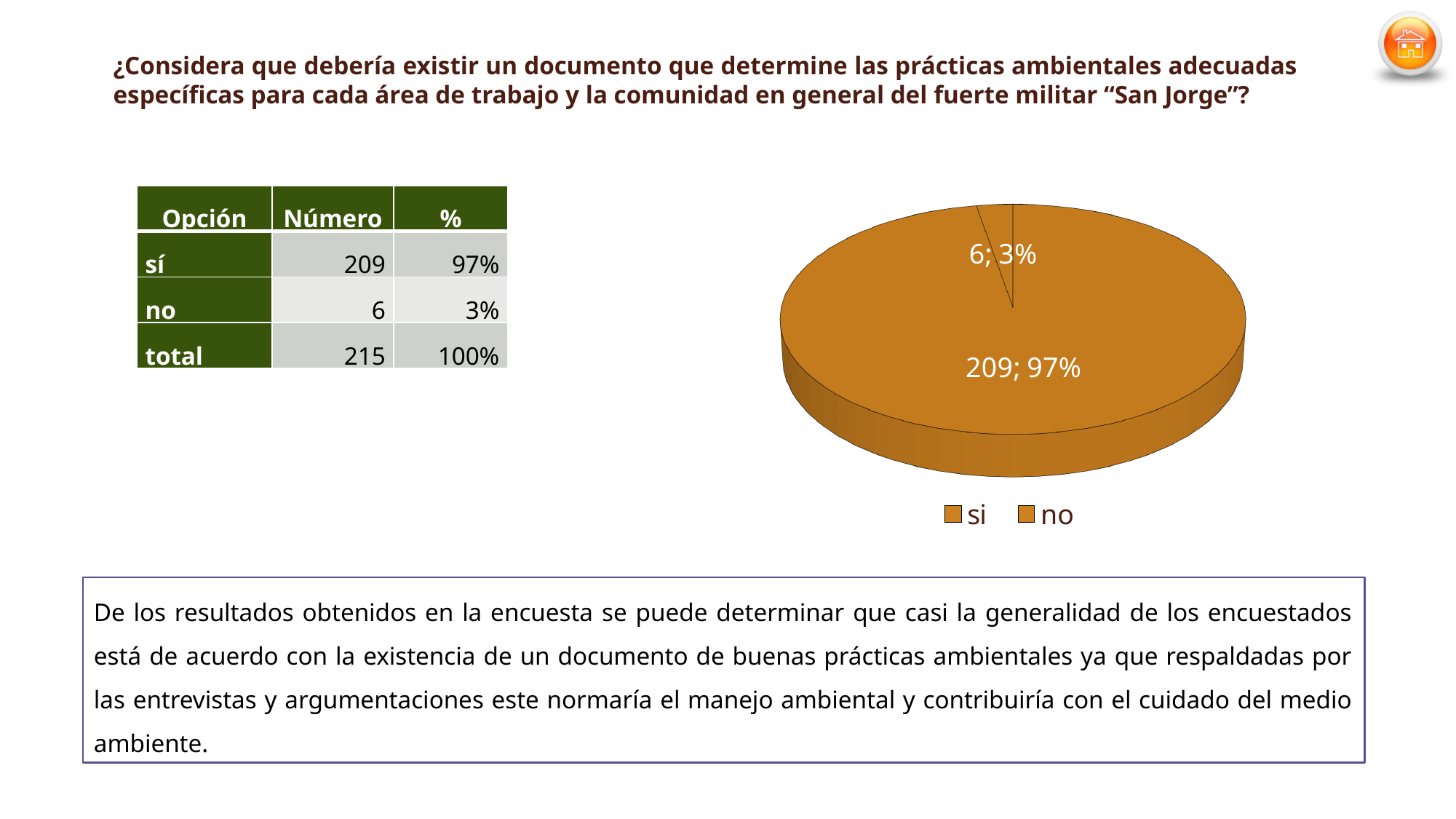
What kind of chart is shown on the slide? pie chart What is the count shown for the 'no' slice of the pie chart? 6 What are the legend entries of the pie chart? si, no Which slice of the pie chart is the largest? si Which is larger in the pie chart, the 'si' slice or the 'no' slice? si What percentage share of the pie does the 'no' slice represent? 3% How many slices does the pie chart have? 2 Which slice of the pie chart is the smallest? no What is the count shown for the 'si' slice of the pie chart? 209 What is the difference between the counts for 'si' and 'no' in the pie chart? 203 What percentage share of the pie does the 'si' slice represent? 97% How many entries does the legend of the pie chart list? 2